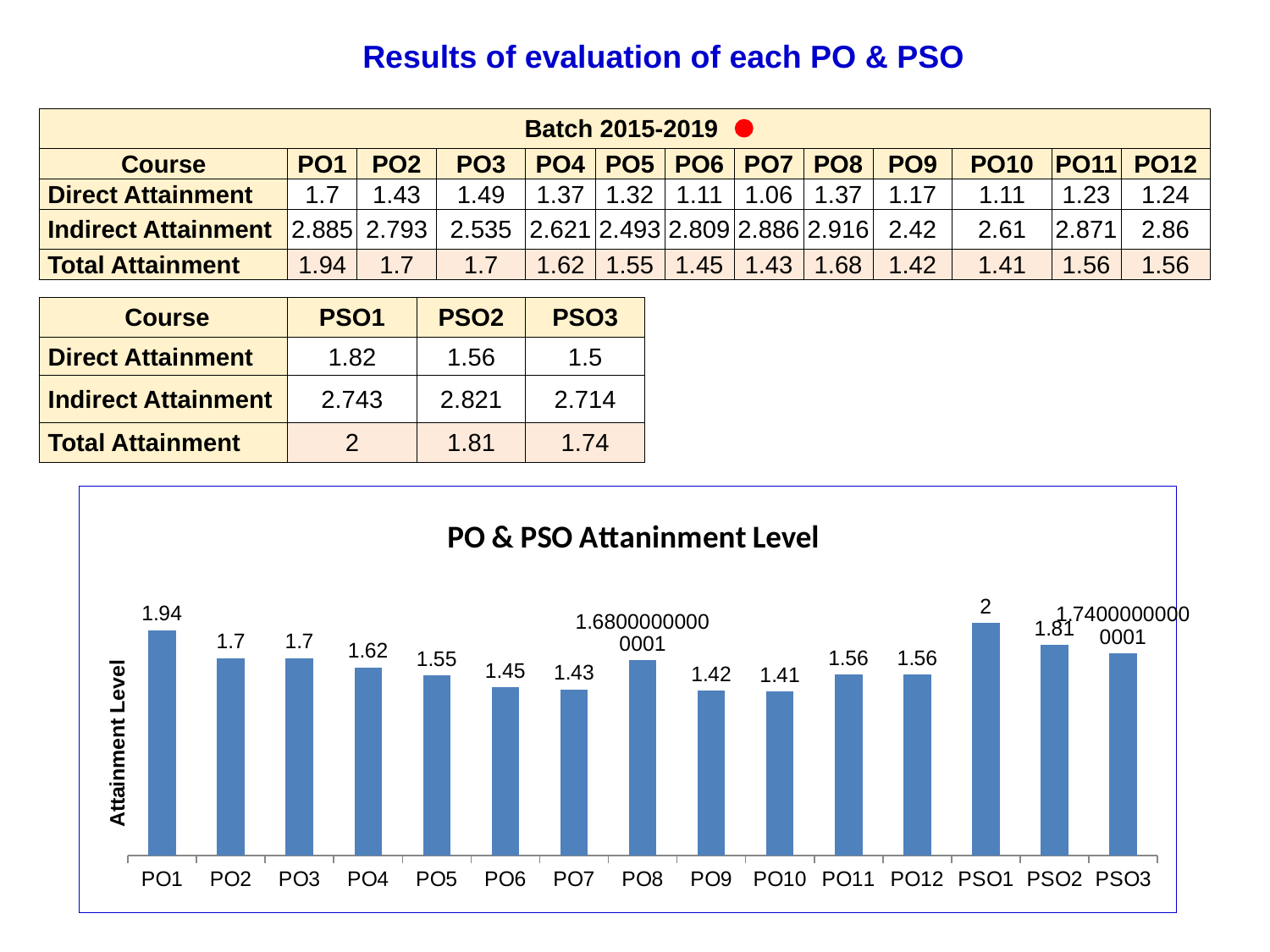
Which category has the lowest attainment level in the chart? PO10 Which has a higher attainment level in the chart, PO1 or PSO2? PO1 What is the attainment level for PO11 in the chart? 1.56 What is the attainment level for PSO2 in the chart? 1.81 What is the difference between the attainment levels of PO1 and PO2 in the chart? 0.24 How many categories are plotted in the PO & PSO Attaninment Level chart? 15 What is the difference between the attainment levels of PSO1 and PO10 in the chart? 0.59 What is the title of the chart on the slide? PO & PSO Attaninment Level What is the attainment level for PO1 in the PO & PSO Attaninment Level chart? 1.94 What is the attainment level for PO4 in the chart? 1.62 What kind of chart is shown on the slide? Bar chart Which category has the highest attainment level in the chart? PSO1